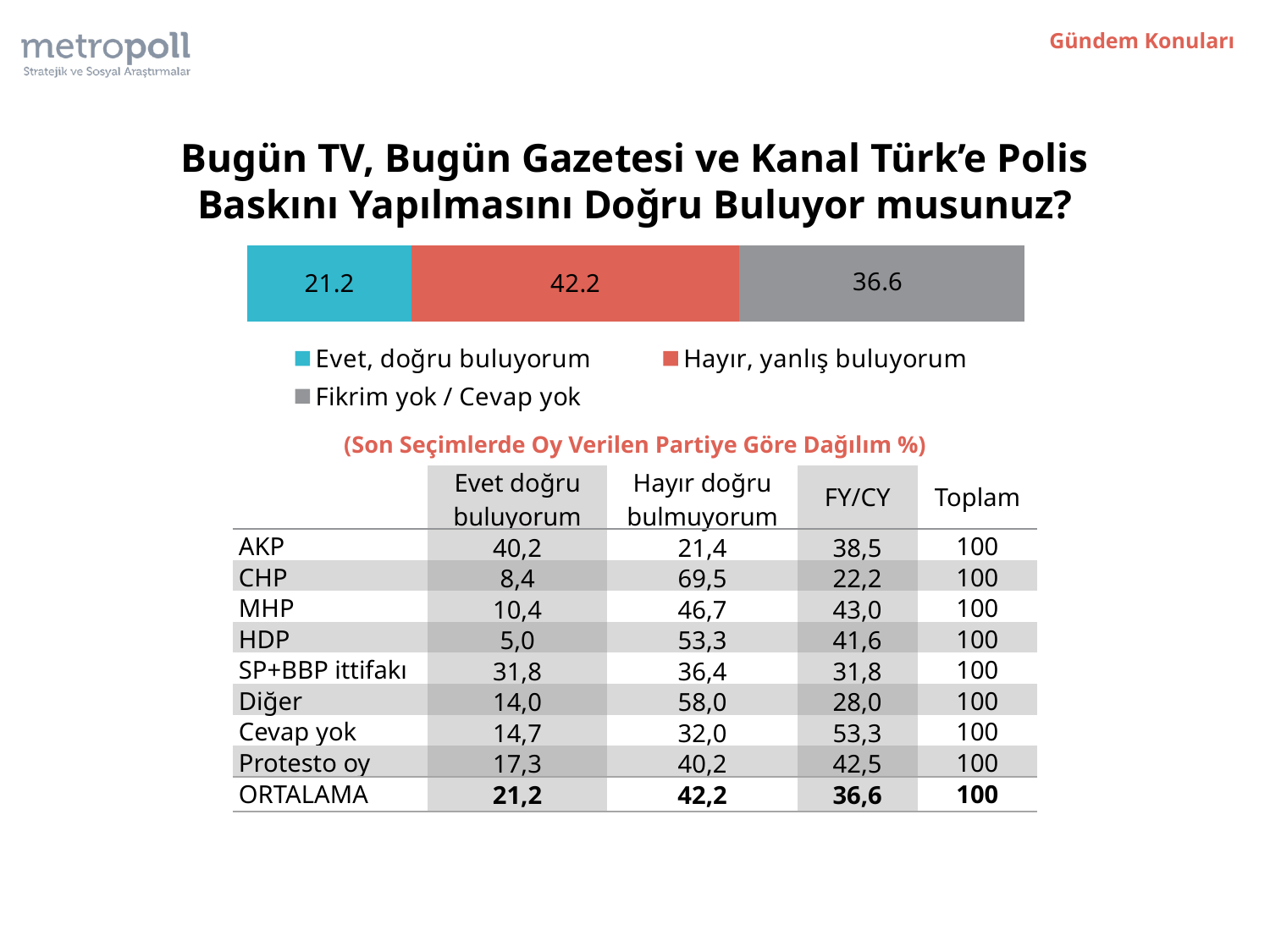
What colour is the "Hayır, yanlış buluyorum" segment in the bar? Red What is the total of the three segments in the stacked bar? 100 Which is larger: the value for "Hayır, yanlış buluyorum" or the value for "Fikrim yok / Cevap yok"? Hayır, yanlış buluyorum Which legend category has the largest segment in the bar? Hayır, yanlış buluyorum What is the value for "Evet, doğru buluyorum" in the stacked bar? 21.2 What is the value for "Hayır, yanlış buluyorum" in the stacked bar? 42.2 What is the title of the chart? Bugün TV, Bugün Gazetesi ve Kanal Türk'e Polis Baskını Yapılmasını Doğru Buluyor musunuz? What is the value for "Fikrim yok / Cevap yok" in the stacked bar? 36.6 What is the difference between the "Hayır, yanlış buluyorum" value and the "Evet, doğru buluyorum" value? 21.0 Which legend category has the smallest segment in the bar? Evet, doğru buluyorum How many series does the chart legend list? 3 What kind of chart is shown on the slide? Stacked bar chart